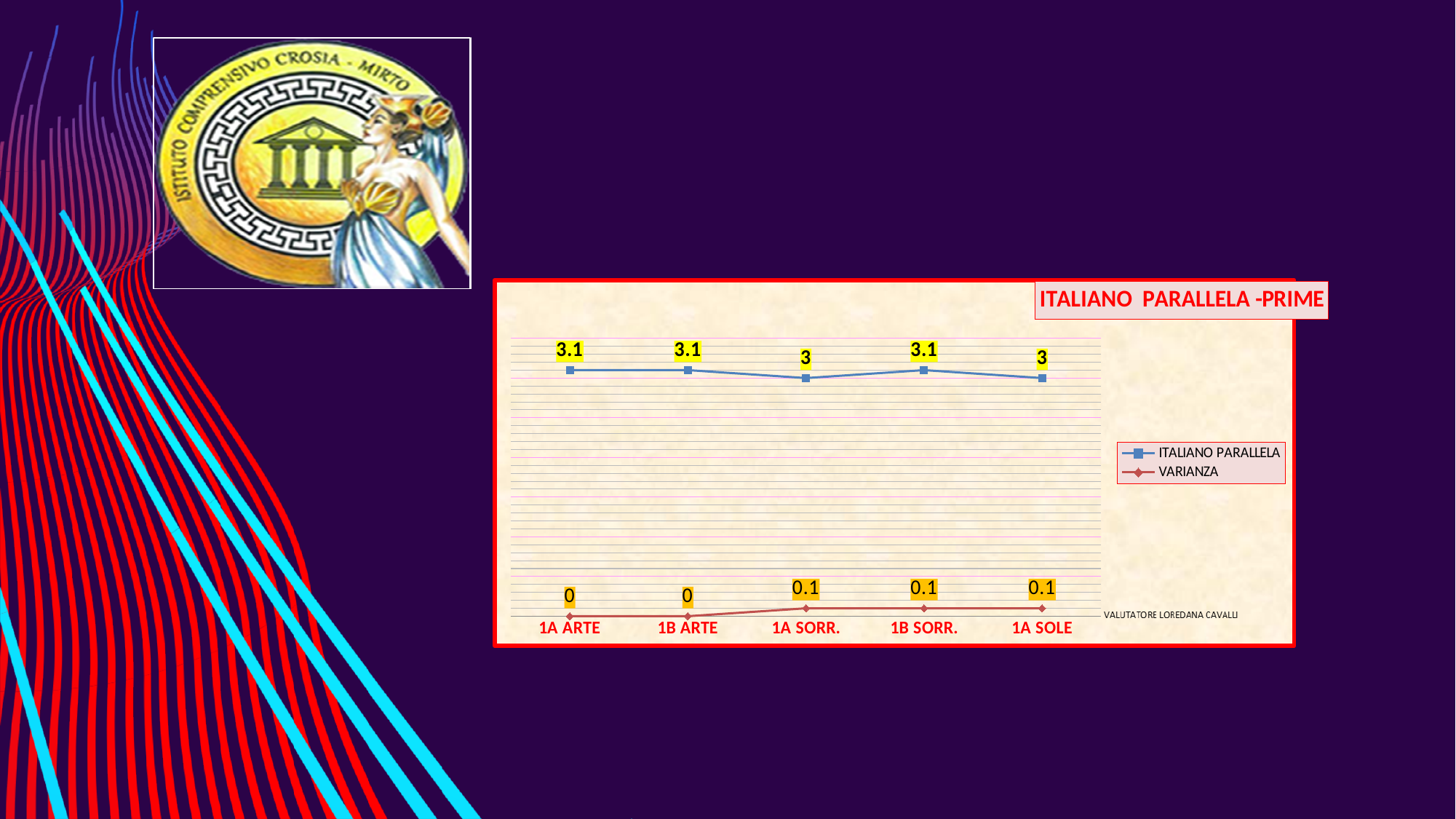
What is the VARIANZA value for 1A SOLE? 0.1 What is the title of the chart? ITALIANO PARALLELA -PRIME Which category has the lowest VARIANZA value? 1A ARTE and 1B ARTE (both 0) Which is larger, the ITALIANO PARALLELA value for 1B ARTE or for 1A SORR.? 1B ARTE How many series does the legend list? 2 What is the ITALIANO PARALLELA value for 1A ARTE? 3.1 How many categories are shown on the x axis? 5 Which series is drawn in blue? ITALIANO PARALLELA What is the VARIANZA value for 1B ARTE? 0 What is the ITALIANO PARALLELA value for 1A SORR.? 3 What kind of chart is this? line chart What is the difference between the ITALIANO PARALLELA values for 1B SORR. and 1A SOLE? 0.1